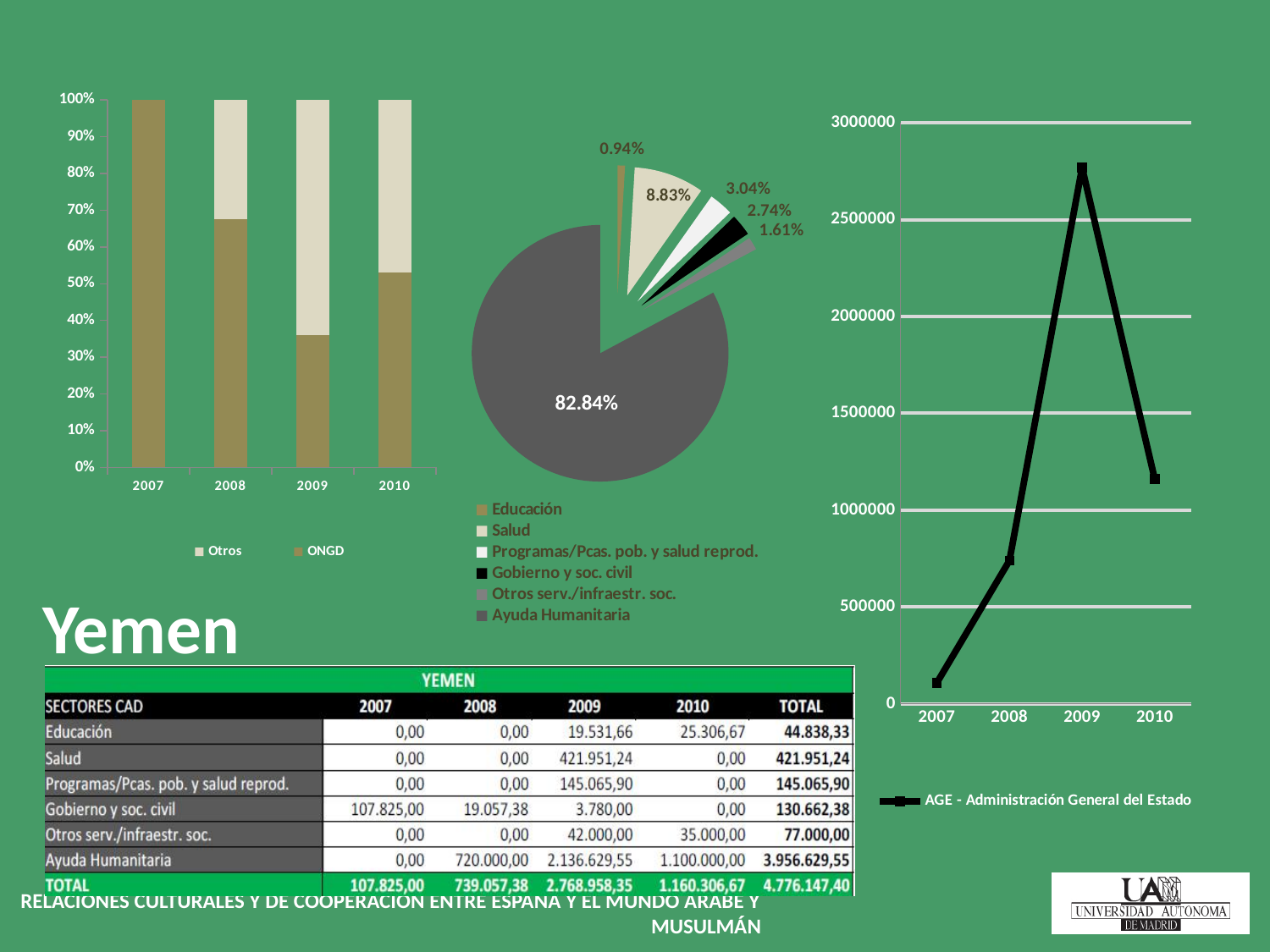
In the pie chart, what share does Salud have? 8.83% What kind of chart is the chart on the right showing AGE - Administración General del Estado? line chart In the pie chart, which sector has the largest slice? Ayuda Humanitaria In the pie chart, which sector has the smallest slice? Educación How many slices does the pie chart have? 6 In the pie chart, what share does Ayuda Humanitaria have? 82.84% In the line chart on the right, which year has the highest value? 2009 In the pie chart, what is the difference between the Ayuda Humanitaria share and the Salud share? 74.01% In the stacked bar chart on the left, how many series does the legend list? 2 In the line chart on the right, is the value for 2008 greater or less than 1000000? less In the stacked bar chart on the left, is the ONGD share for 2009 greater or less than 50%? less In the stacked bar chart on the left, which year has the largest ONGD share? 2007